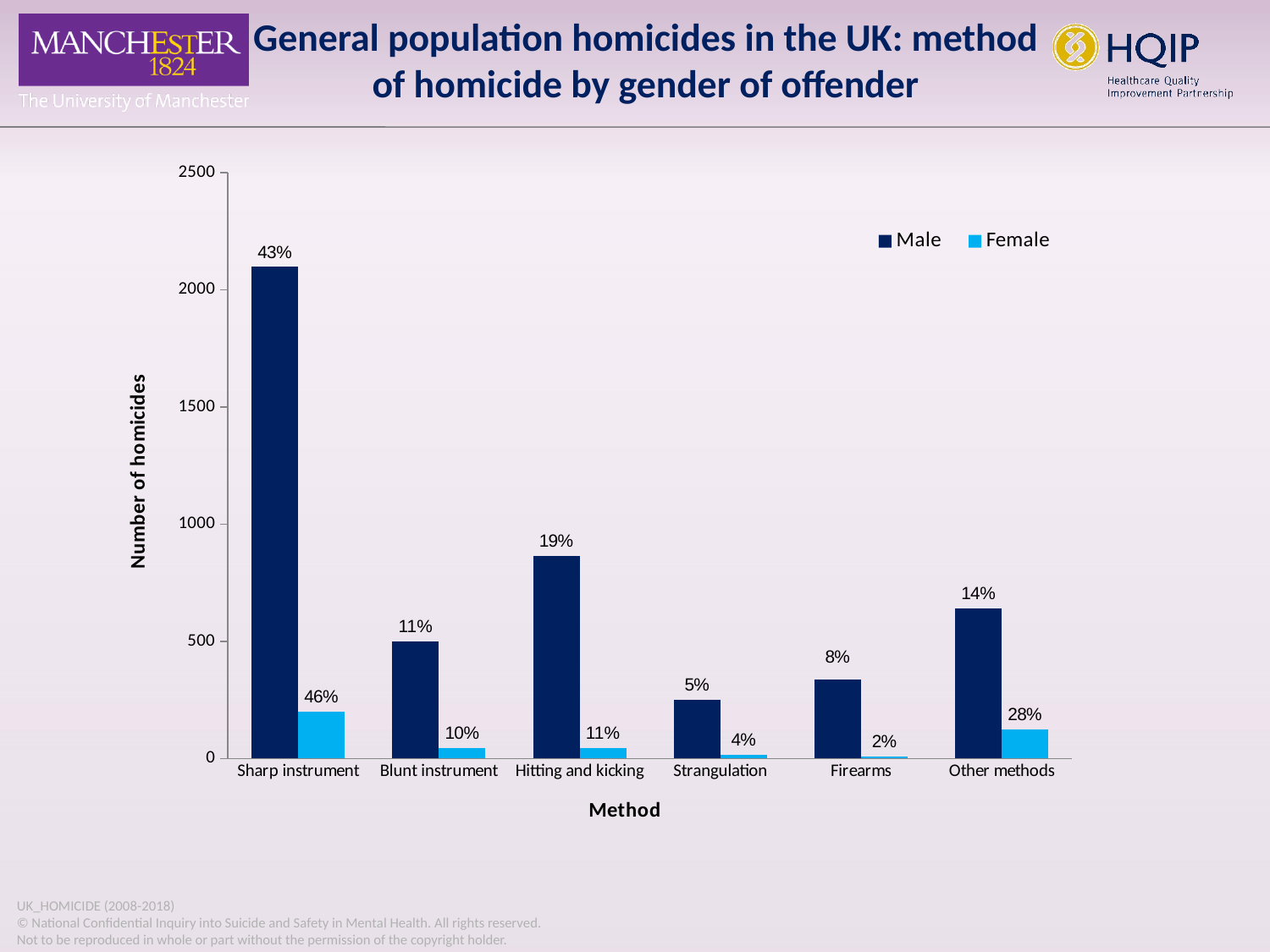
What percentage label is shown on the Male bar for Sharp instrument? 43% What percentage label is shown on the Female bar for Other methods? 28% Which method has the lowest number of homicides for Female offenders? Firearms What percentage label is shown on the Female bar for Firearms? 2% Which is larger: the number of homicides for Male offenders by Hitting and kicking or by Blunt instrument? Hitting and kicking What type of chart is shown on the slide? bar chart What percentage label is shown on the Male bar for Hitting and kicking? 19% Which method has the highest number of homicides for Male offenders? Sharp instrument Is the number of homicides for Male offenders using Firearms greater or less than 500? less How many method categories are shown on the x axis? 6 Is the number of homicides for Male offenders using a Sharp instrument greater or less than 2000? greater How many series does the legend list? 2